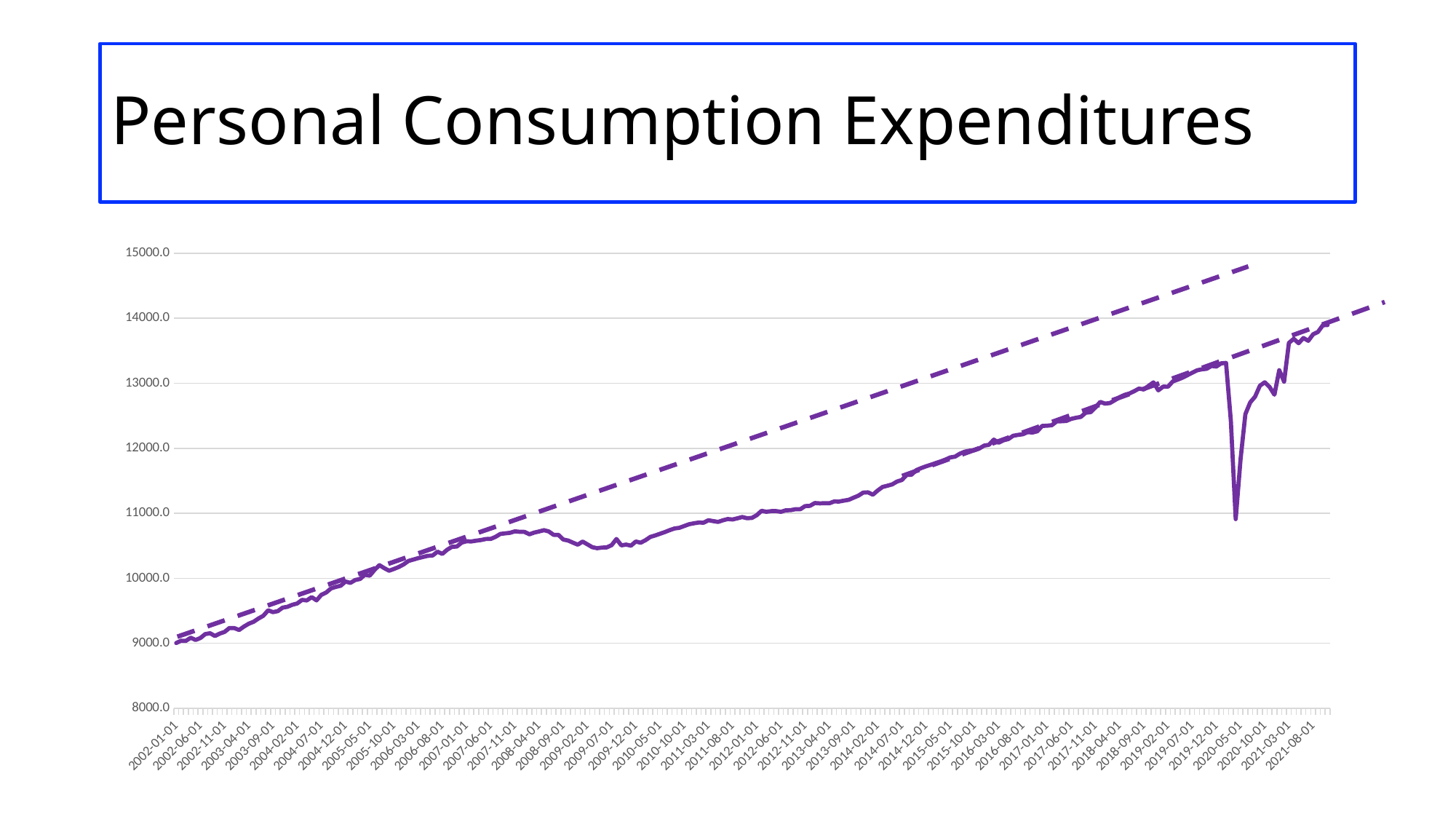
Is the value of the solid line at 2009-07-01 greater or less than 11000? less Is the value of the solid line at 2014-07-01 greater or less than 11000? greater What kind of chart is shown on the slide? line chart Overall, does the solid line rise or fall from 2002-01-01 to 2021-08-01? rise Is the value of the solid line at 2017-06-01 greater or less than 12000? greater Between 2008-04-01 and 2009-07-01, does the solid line rise or fall? fall Which is larger, the value of the solid line at 2012-06-01 or at 2018-04-01? 2018-04-01 What is the highest value shown on the vertical axis? 15000.0 In which year does the solid line reach its lowest value? 2002 What is the title of the slide? Personal Consumption Expenditures